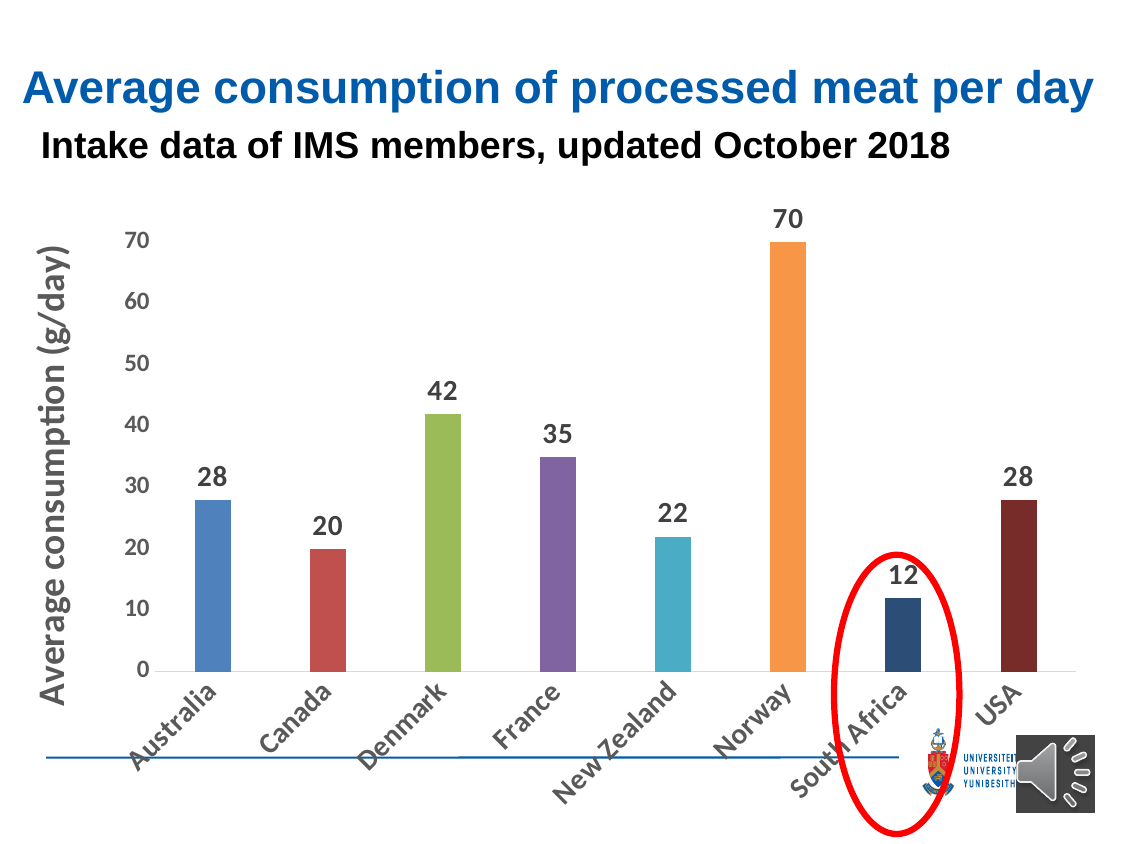
Which country has the lowest average consumption of processed meat per day? South Africa Is the value for Canada greater or less than 30? less What is the difference between the values for Norway and South Africa? 58 What kind of chart is shown on the slide? bar chart Which has a higher value, France or New Zealand? France What is the average consumption of processed meat per day for Norway? 70 What is the value shown for Denmark? 42 Which country has the highest average consumption of processed meat per day? Norway What is the value shown for South Africa? 12 What is the label of the vertical axis? Average consumption (g/day) How many countries are shown on the chart? 8 What is the difference between the values for Denmark and France? 7